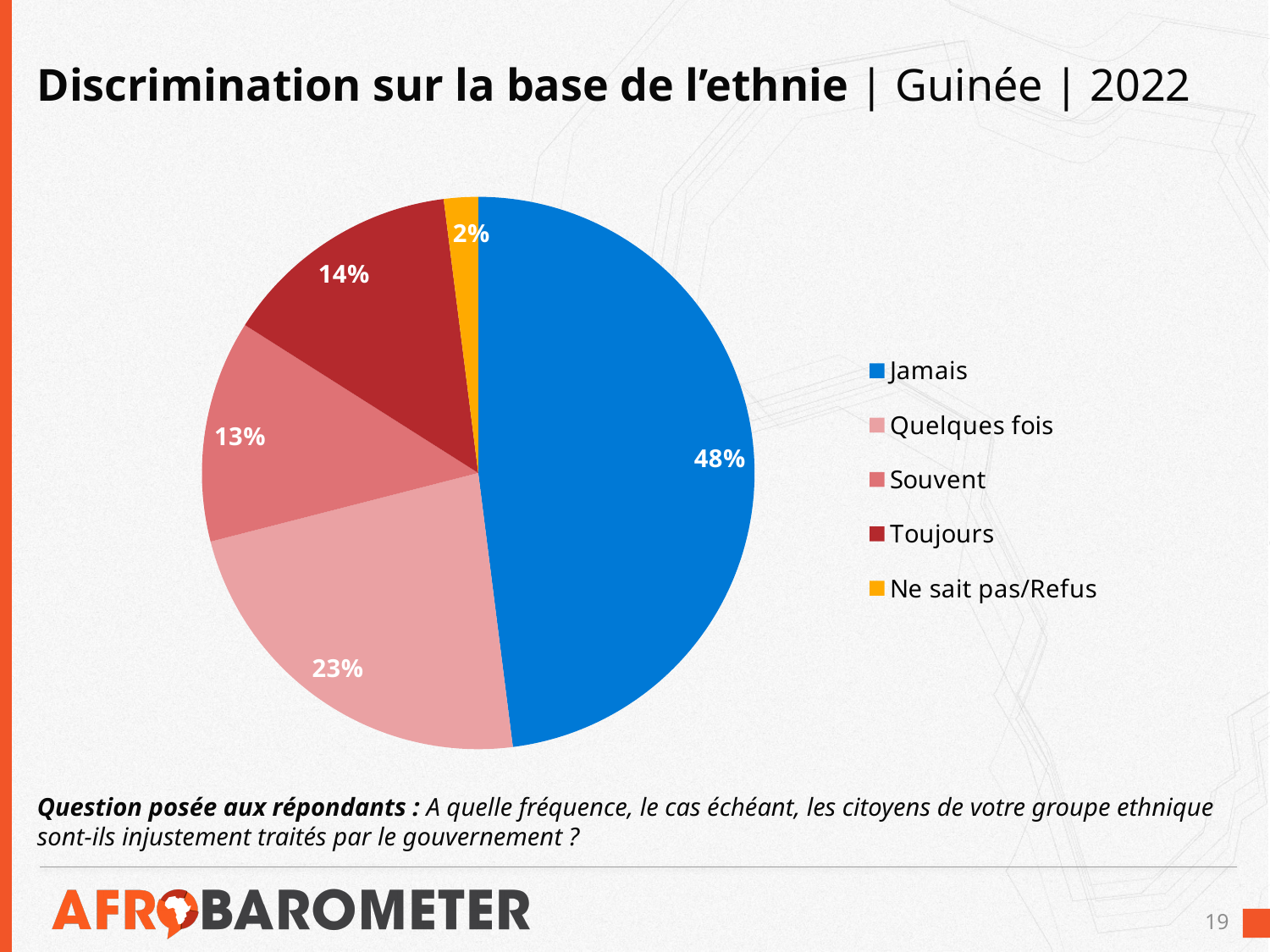
What percentage is shown for "Toujours"? 14% How many categories does the legend list? 5 What colour is the slice for "Jamais"? Blue What is the value shown for "Souvent"? 13% Which response category has the smallest share of the pie? Ne sait pas/Refus What is the value for "Ne sait pas/Refus"? 2% Which is larger, the share for "Quelques fois" or the share for "Souvent"? Quelques fois What share of the pie is labelled "Quelques fois"? 23% What percentage of respondents answered "Jamais"? 48% What is the difference in percentage points between "Jamais" and "Quelques fois"? 25 Which response category has the largest share of the pie? Jamais What type of chart is shown on the slide? Pie chart